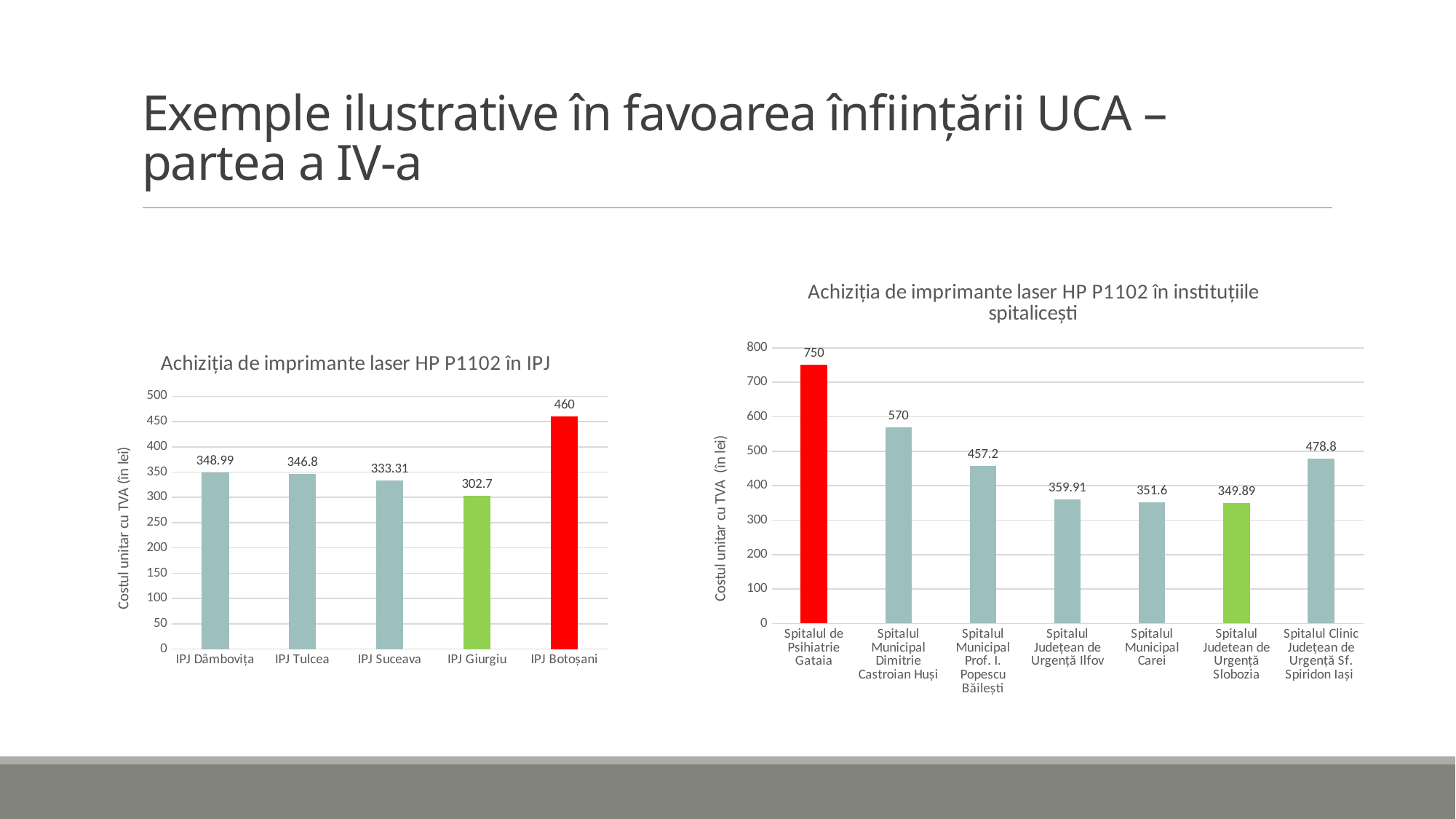
In the chart 'Achiziția de imprimante laser HP P1102 în IPJ', what is the value for IPJ Giurgiu? 302.7 In the chart 'Achiziția de imprimante laser HP P1102 în instituțiile spitalicești', which category has the lowest value? Spitalul Judetean de Urgență Slobozia In the chart 'Achiziția de imprimante laser HP P1102 în instituțiile spitalicești', what is the difference between the values for Spitalul de Psihiatrie Gataia and Spitalul Municipal Dimitrie Castroian Huși? 180 In the chart 'Achiziția de imprimante laser HP P1102 în instituțiile spitalicești', which is larger: the value for Spitalul Municipal Prof. I. Popescu Băilești or the value for Spitalul Clinic Județean de Urgență Sf. Spiridon Iași? Spitalul Clinic Județean de Urgență Sf. Spiridon Iași In the chart 'Achiziția de imprimante laser HP P1102 în IPJ', which category has the lowest value? IPJ Giurgiu In the chart 'Achiziția de imprimante laser HP P1102 în instituțiile spitalicești', which category has the highest value? Spitalul de Psihiatrie Gataia In the chart 'Achiziția de imprimante laser HP P1102 în IPJ', how many categories are shown? 5 What type of chart is 'Achiziția de imprimante laser HP P1102 în IPJ'? Bar chart In the chart 'Achiziția de imprimante laser HP P1102 în instituțiile spitalicești', how many categories are shown? 7 In the chart 'Achiziția de imprimante laser HP P1102 în IPJ', what is the difference between the values for IPJ Botoșani and IPJ Giurgiu? 157.3 In the chart 'Achiziția de imprimante laser HP P1102 în IPJ', which category has the highest value? IPJ Botoșani In the chart 'Achiziția de imprimante laser HP P1102 în instituțiile spitalicești', what is the value for Spitalul Municipal Carei? 351.6